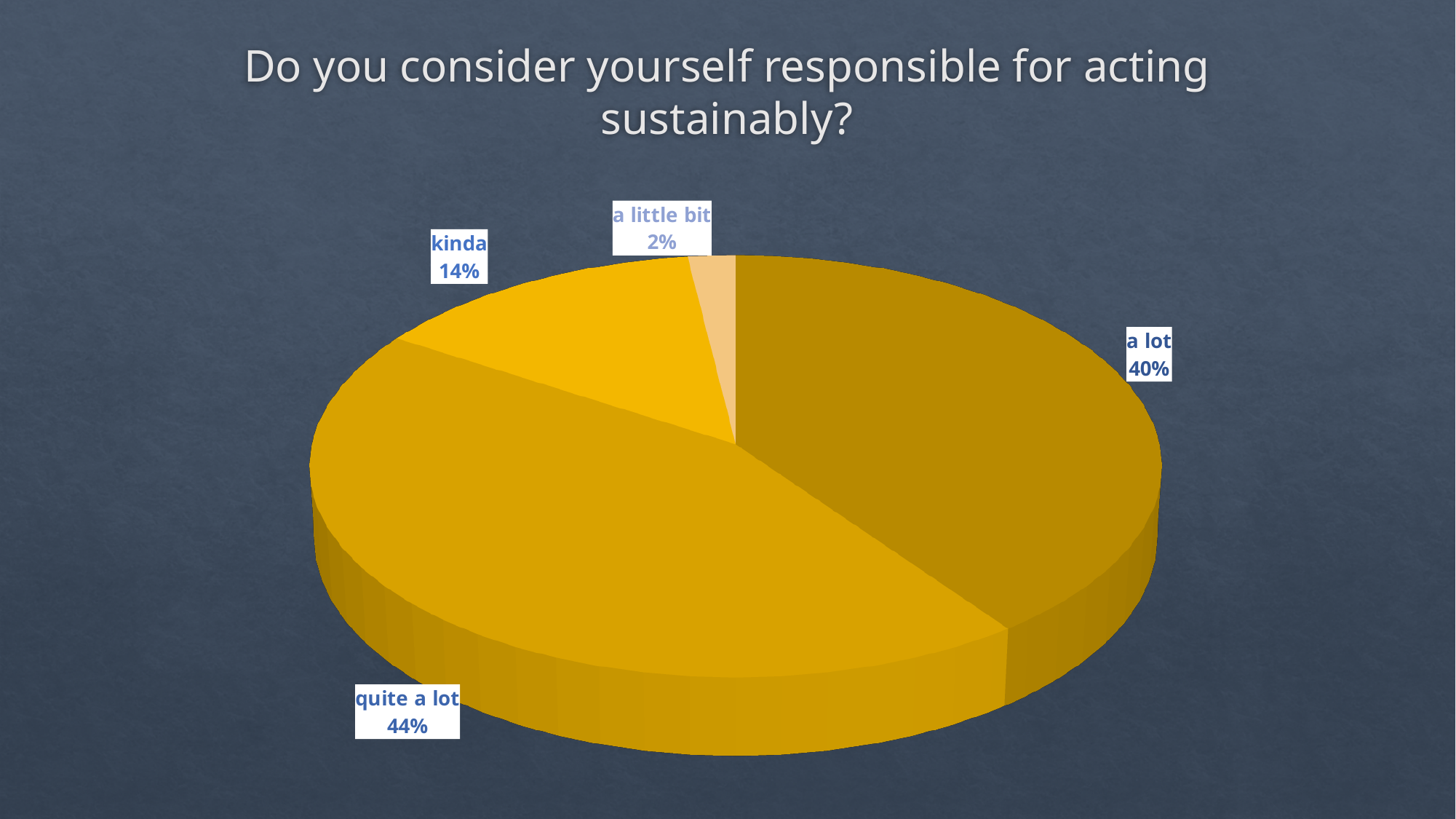
What percentage of respondents answered "a lot"? 40% What is the difference in percentage points between "kinda" and "a little bit"? 12 Which response has the smallest share of the pie? a little bit Which is larger, the share for "kinda" or the share for "a little bit"? kinda What is the title of the chart? Do you consider yourself responsible for acting sustainably? What percentage of respondents answered "kinda"? 14% Which response has the largest share of the pie? quite a lot What percentage of respondents answered "a little bit"? 2% What is the difference in percentage points between "quite a lot" and "a lot"? 4 What kind of chart is shown on the slide? pie chart What percentage of respondents answered "quite a lot"? 44% How many slices does the pie chart have? 4